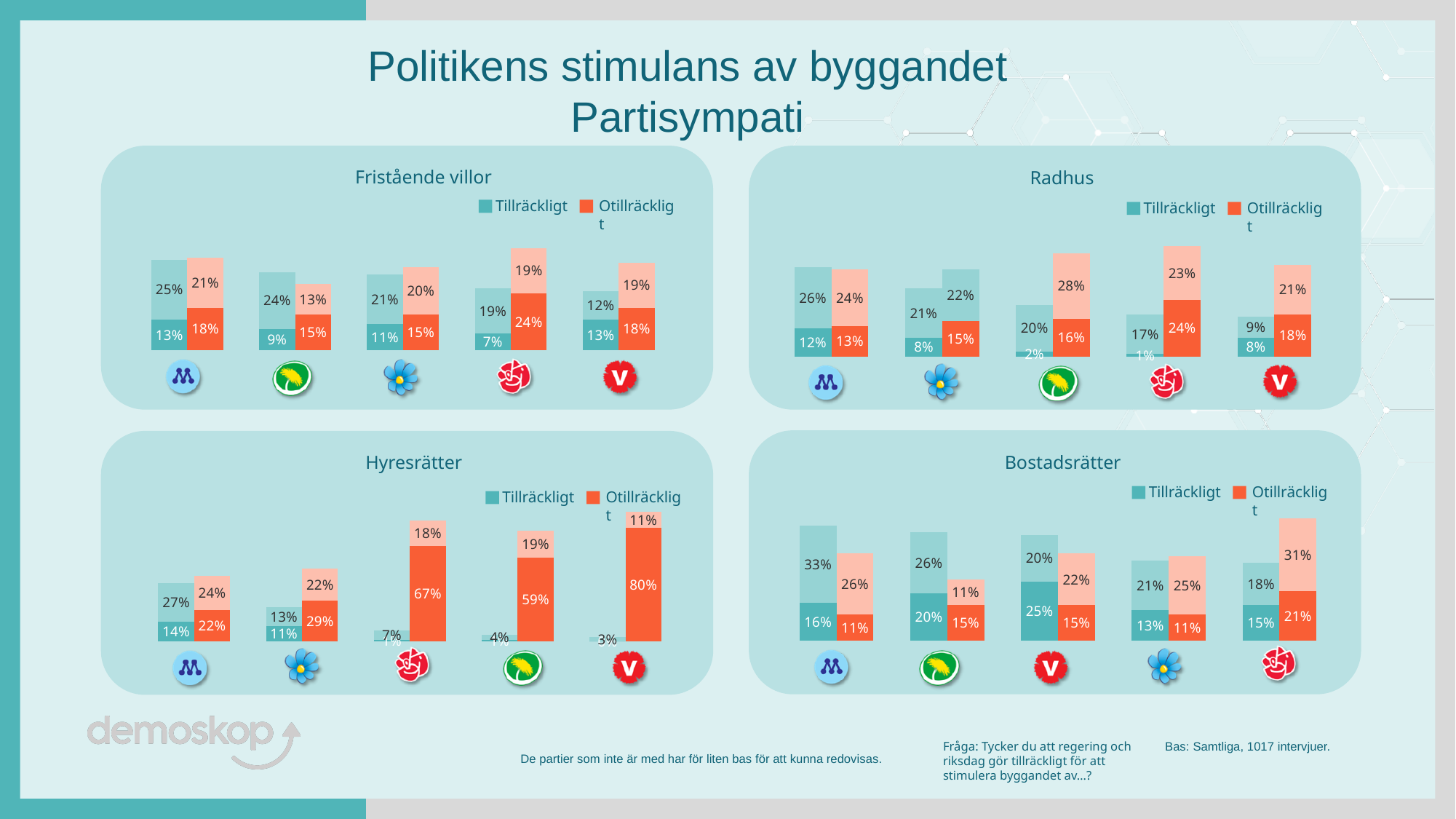
In the Hyresrätter chart, what is the total of the stacked Otillräckligt bar in the fifth (rightmost) group? 91% In the Radhus chart, what is the value of the dark teal Tillräckligt segment in the fourth group from the left? 1% In the Hyresrätter chart, how many series does the legend list? 2 What are the two legend entries in the Bostadsrätter chart? Tillräckligt and Otillräckligt In the Bostadsrätter chart, what is the difference between the light orange Otillräckligt segment (31%) and the dark orange segment (21%) in the fifth (rightmost) group? 10% What kind of chart is the Radhus chart? Bar chart In the Hyresrätter chart, what is the value of the dark orange Otillräckligt segment in the fifth (rightmost) group? 80% In the Bostadsrätter chart, what is the value of the light teal Tillräckligt segment in the first (leftmost) group? 33% In the Hyresrätter chart, which group has the largest dark orange Otillräckligt segment? The fifth (rightmost) group In the Fristående villor chart, which is larger in the fourth group from the left: the dark teal Tillräckligt segment or the dark orange Otillräckligt segment? The dark orange Otillräckligt segment (24%) How many charts are on the slide? 4 In the Fristående villor chart, how many party groups are plotted along the x axis? 5